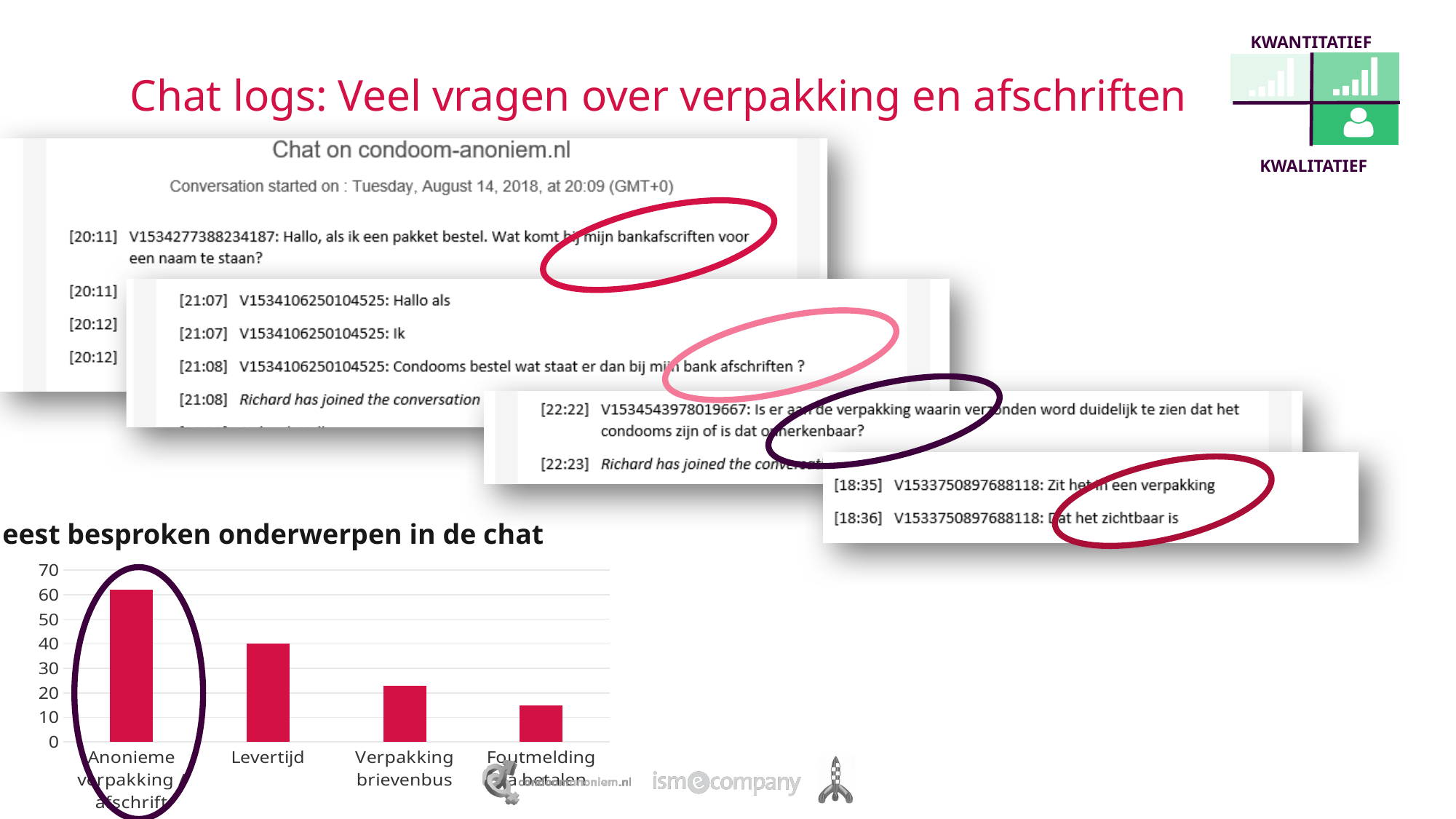
Which category has the highest value in the bar chart? Anonieme verpakking / afschrift What is the highest value shown on the vertical axis of the bar chart? 70 What kind of chart is shown at the bottom left of the slide? bar chart Is the value for Anonieme verpakking / afschrift greater or less than 60? greater What is the value for Levertijd in the bar chart? 40 Which has a larger value, Levertijd or Verpakking brievenbus? Levertijd Do the bar values rise or fall from left to right across the categories? fall How many categories are shown on the bar chart? 4 Is the value for Foutmelding na betalen greater or less than 20? less Is the value for Verpakking brievenbus greater or less than 30? less Which category has the lowest value in the bar chart? Foutmelding na betalen